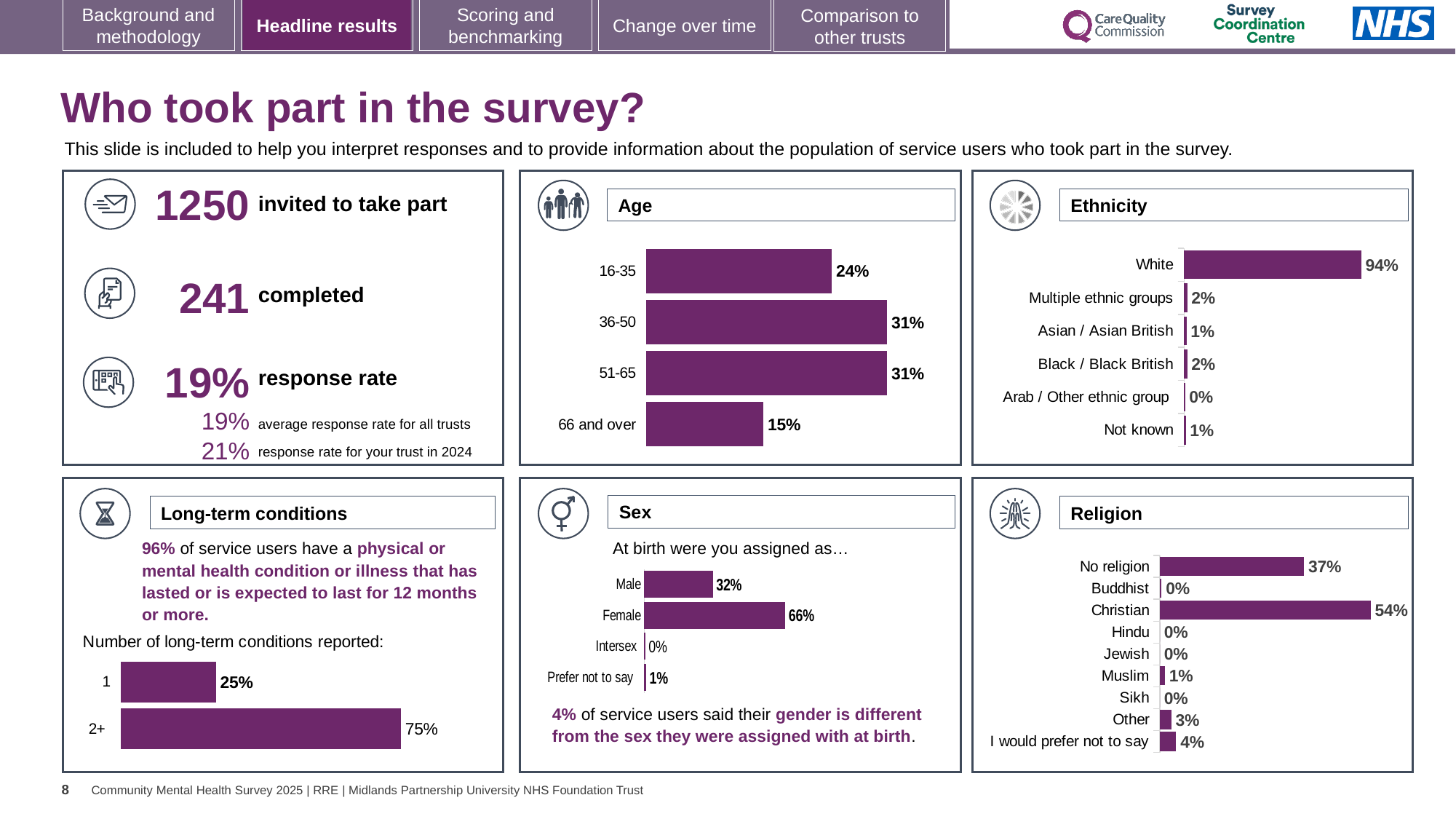
In the Religion chart, which religion category has the highest percentage? Christian In the Religion chart, what is the value for 'I would prefer not to say'? 4% In the Ethnicity chart, what is the value for White? 94% In the Age chart, which age group has the lowest percentage? 66 and over In the Ethnicity chart, how many ethnic categories are shown? 6 In the Long-term conditions chart, what percentage of service users reported 2+ long-term conditions? 75% What type of chart is used in the Age panel? Bar chart In the Religion chart, what is the value for No religion? 37% In the Age chart, what percentage of respondents were aged 16-35? 24% In the Long-term conditions chart, what is the difference between the 2+ and 1 categories? 50% In the Sex chart, which is larger, Male or Female? Female In the Sex chart, what is the difference between the Female and Male percentages? 34%